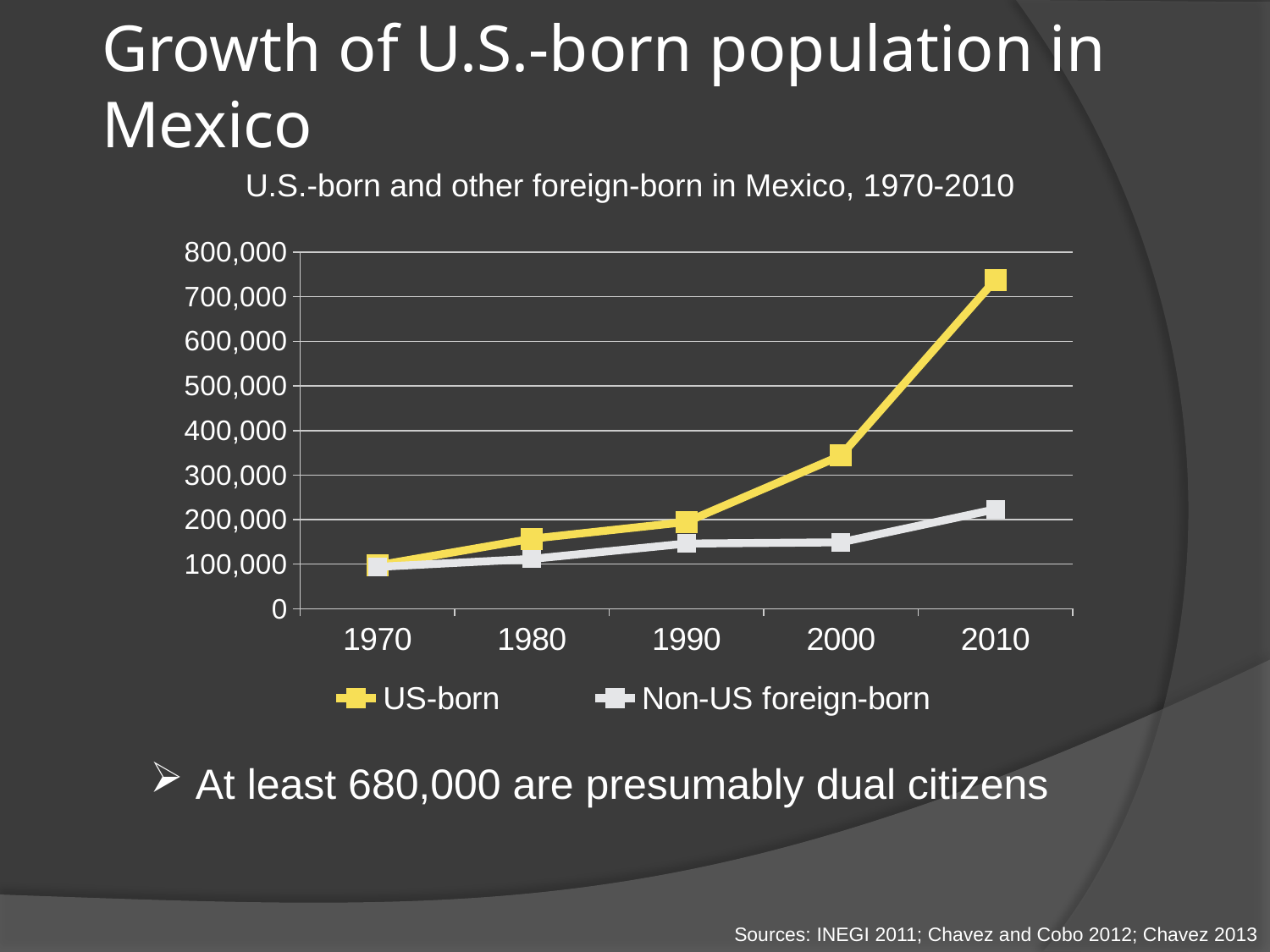
How many years are plotted along the x axis of the chart? 5 Is the US-born value for 2010 greater or less than 700,000? greater What is the title of the chart? U.S.-born and other foreign-born in Mexico, 1970-2010 Is the US-born value for 2000 greater or less than 300,000? greater In 2010, which series has the larger value, US-born or Non-US foreign-born? US-born How many series does the chart's legend list? 2 Does the US-born series rise or fall from 1970 to 2010? Rises In which year is the US-born series at its highest? 2010 What kind of chart is shown on the slide? Line chart Is the Non-US foreign-born value for 1990 greater or less than 200,000? less In which year is the US-born series at its lowest? 1970